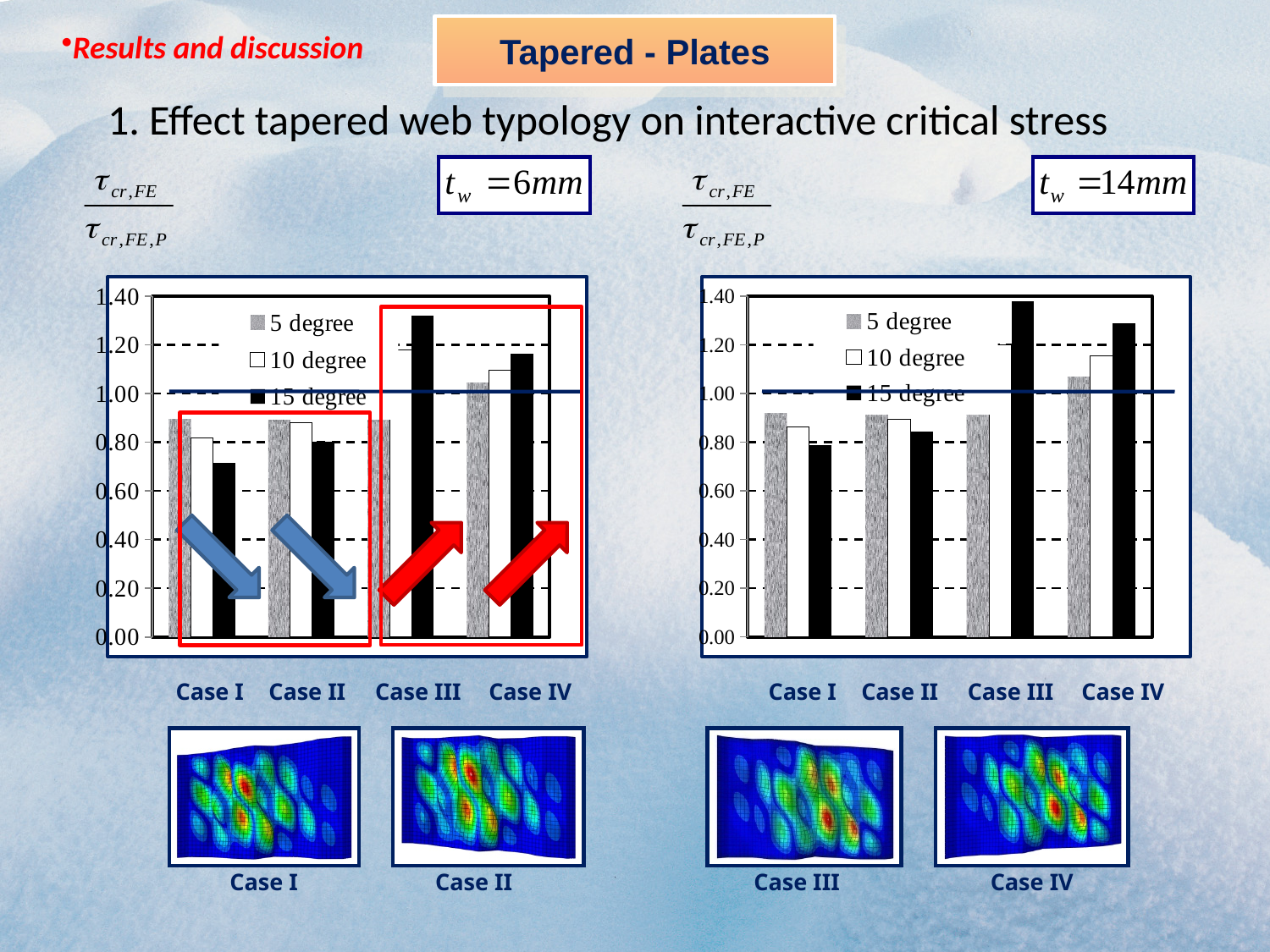
In the left chart (t_w = 6mm), is the 15 degree value for Case I greater or less than 0.80? less What kind of chart is the left chart (t_w = 6mm)? bar chart In the left chart (t_w = 6mm), do the bars for Case I rise or fall going from 5 degree to 15 degree? fall In the right chart (t_w = 14mm), is the 15 degree value for Case IV greater or less than 1.20? greater How many cases are shown along the x axis of the left chart (t_w = 6mm)? 4 In the left chart (t_w = 6mm), is the 15 degree value for Case III greater or less than 1.20? greater How many series does the legend of the right chart (t_w = 14mm) list? 3 In the right chart (t_w = 14mm), which is larger for 15 degree: Case I or Case IV? Case IV In the left chart (t_w = 6mm), which case has the highest 15 degree bar? Case III In the right chart (t_w = 14mm), which case has the lowest 15 degree bar? Case I What are the three legend entries of the left chart (t_w = 6mm)? 5 degree, 10 degree, 15 degree